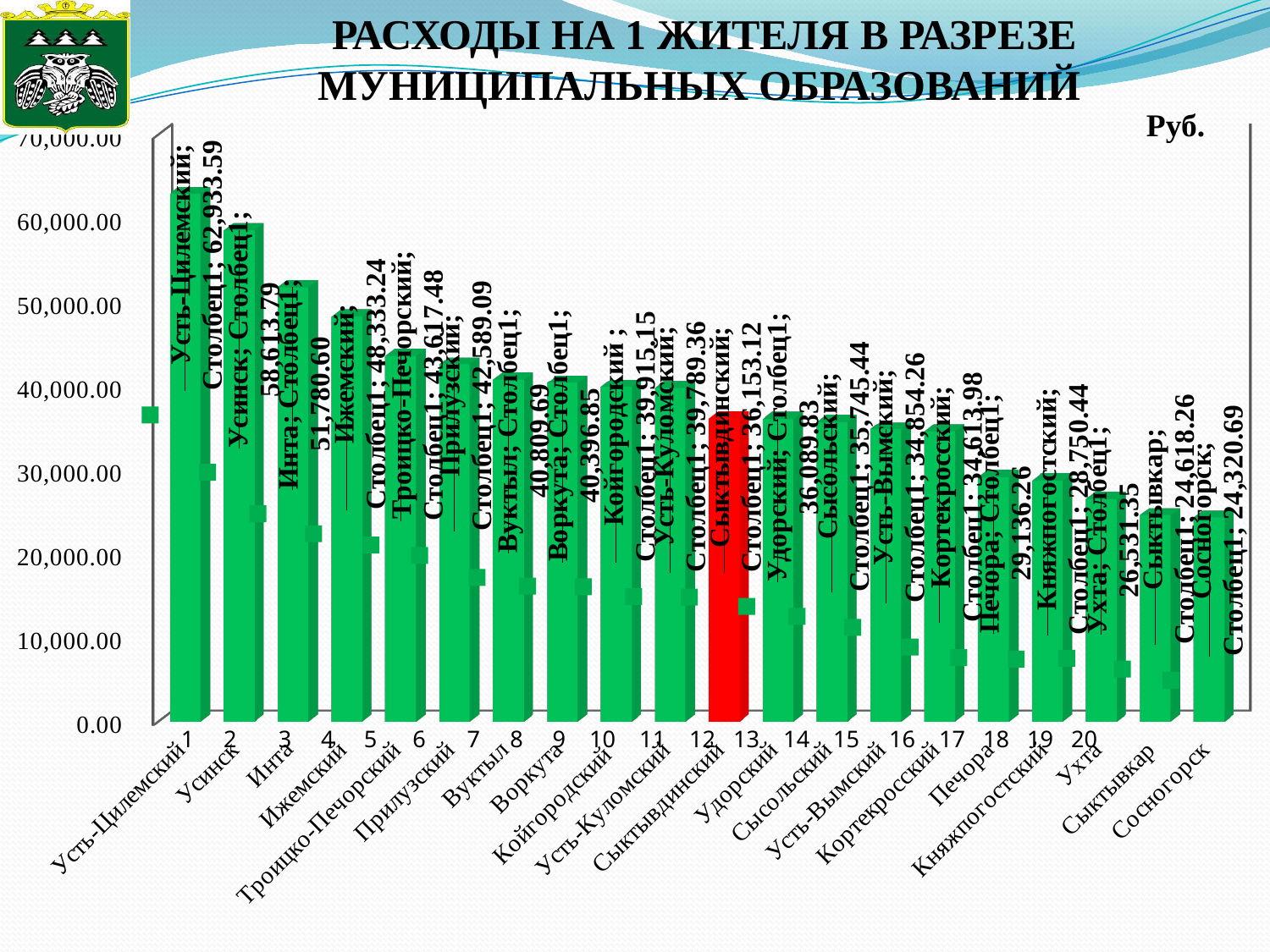
What is the value for Печора? 29,136.26 What is the difference between the values for Усть-Цилемский and Сосногорск? 38,612.90 Which bar is highlighted in red? Сыктывдинский Is the value for Ухта greater or less than 30,000.00? less What type of chart is shown on the slide? Bar chart How many municipalities are shown on the chart? 20 Which municipality has the lowest value? Сосногорск What is the value for Усть-Цилемский? 62,933.59 Which municipality has the highest value? Усть-Цилемский Which is larger, the value for Усинск or the value for Инта? Усинск What is the value for Сыктывдинский? 36,153.12 What is the value for Сосногорск? 24,320.69